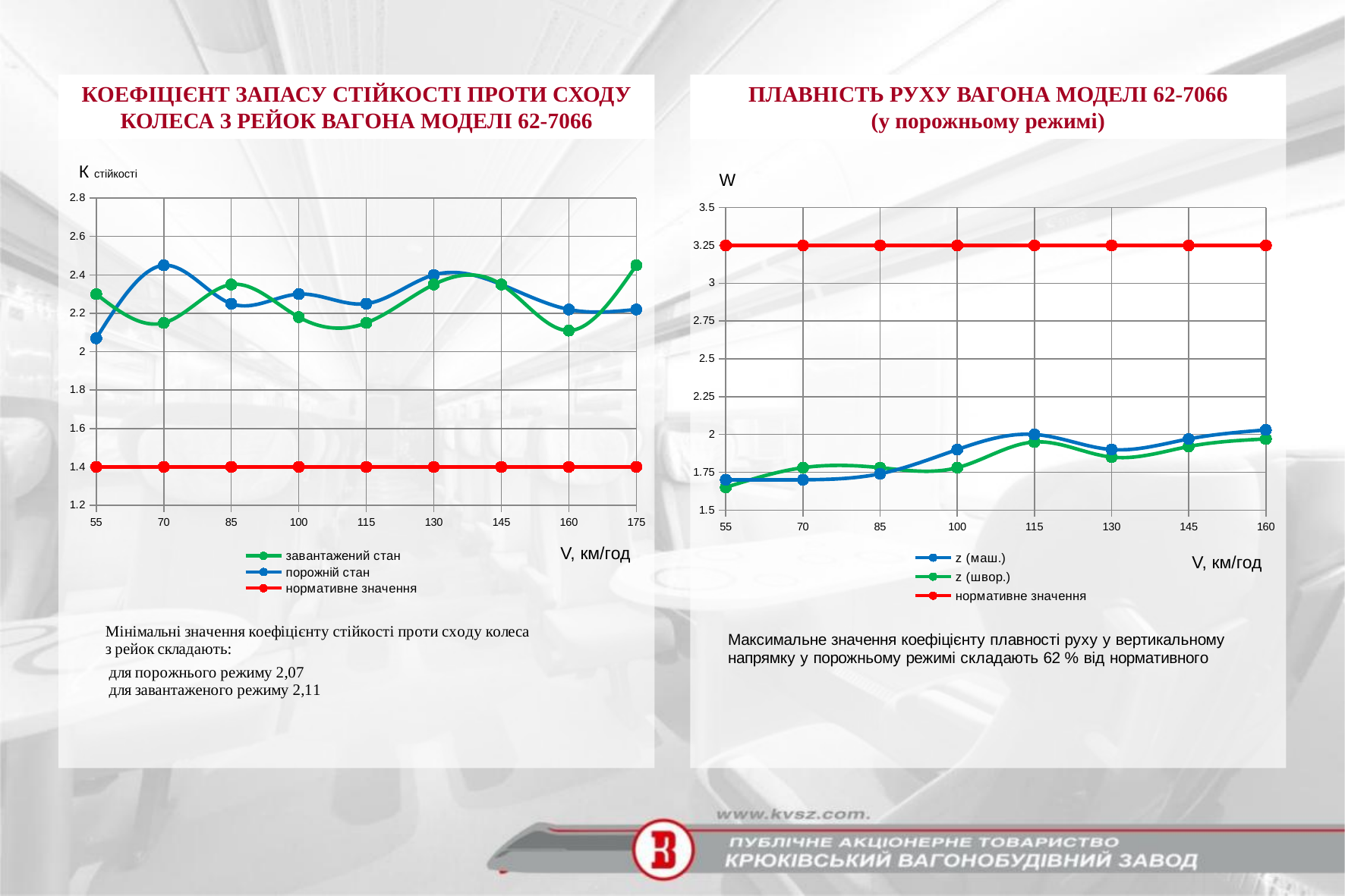
On the left chart, at V = 70 км/год, which series has the larger value: порожній стан or завантажений стан? порожній стан On the right chart, what is the value of the нормативне значення series? 3.25 What kind of chart is the right chart (ПЛАВНІСТЬ РУХУ ВАГОНА МОДЕЛІ 62-7066)? line chart How many speed points are plotted along the x axis of the left chart? 9 On the left chart, what is the value of порожній стан at V = 130 км/год? 2.4 How many series does the legend of the right chart list? 3 On the left chart, is the value of порожній стан at V = 70 км/год greater or less than 2.4? greater On the left chart, is the value of завантажений стан at V = 160 км/год greater or less than 2.2? less On the left chart, what is the value of the нормативне значення series? 1.4 On the right chart, at V = 100 км/год, which series has the larger value: z (маш.) or z (швор.)? z (маш.) On the right chart, is the value of z (швор.) at V = 145 км/год greater or less than 2? less On the right chart, what is the value of z (маш.) at V = 115 км/год? 2